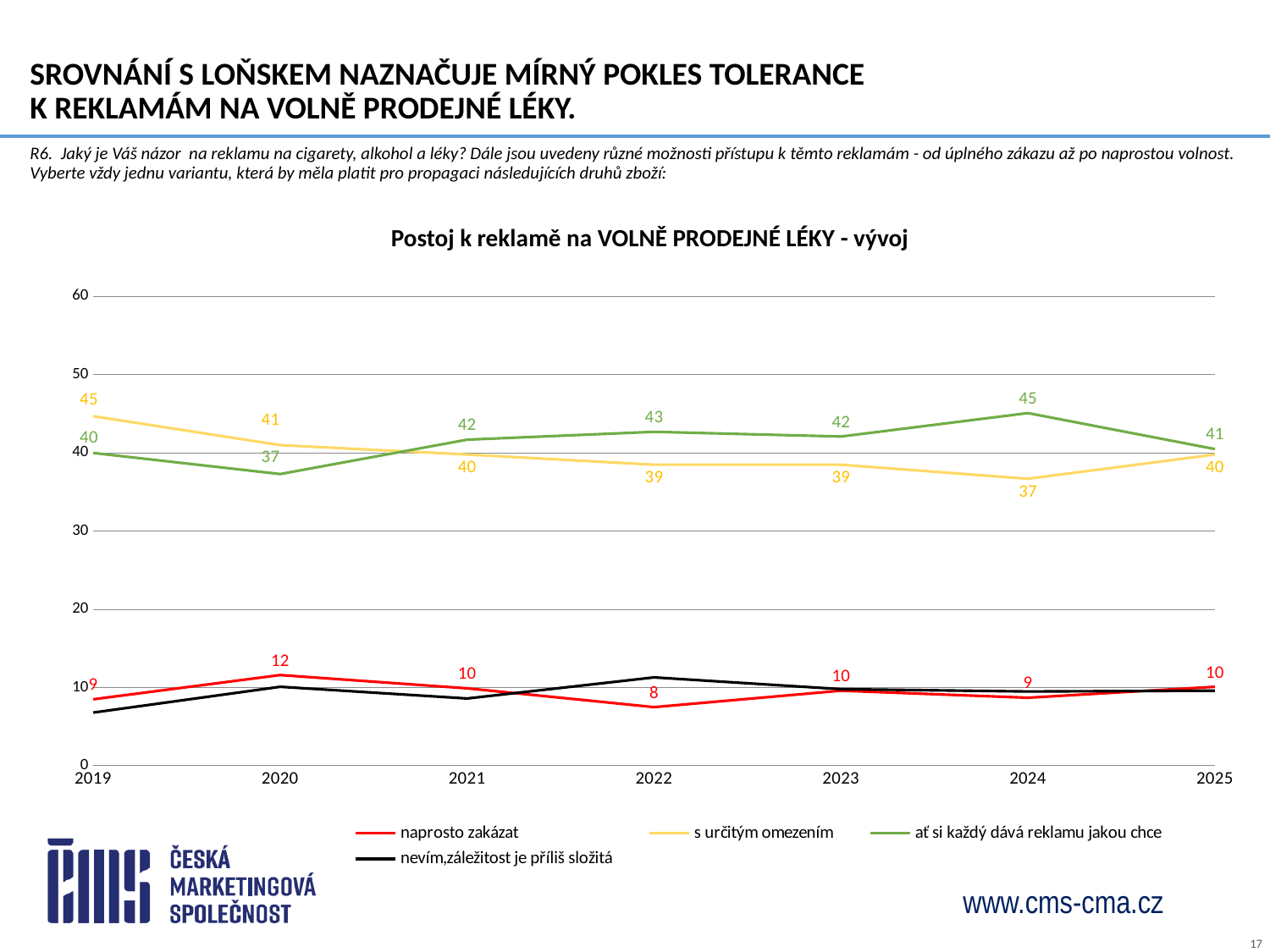
Does the value for 's určitým omezením' rise or fall from 2019 to 2024? fall In which year is the value for 'naprosto zakázat' highest? 2020 Is the value for 'nevím, záležitost je příliš složitá' in 2019 greater or less than 10? less In 2022, which is larger: 'ať si každý dává reklamu jakou chce' or 's určitým omezením'? ať si každý dává reklamu jakou chce What is the difference between the 's určitým omezením' values in 2019 and 2025? 5 What kind of chart is shown? line chart What is the value for 's určitým omezením' in 2019? 45 What is the value for 'ať si každý dává reklamu jakou chce' in 2024? 45 How many years are shown on the x axis? 7 In which year is the value for 's určitým omezením' lowest? 2024 What is the value for 'naprosto zakázat' in 2020? 12 How many series does the legend list? 4